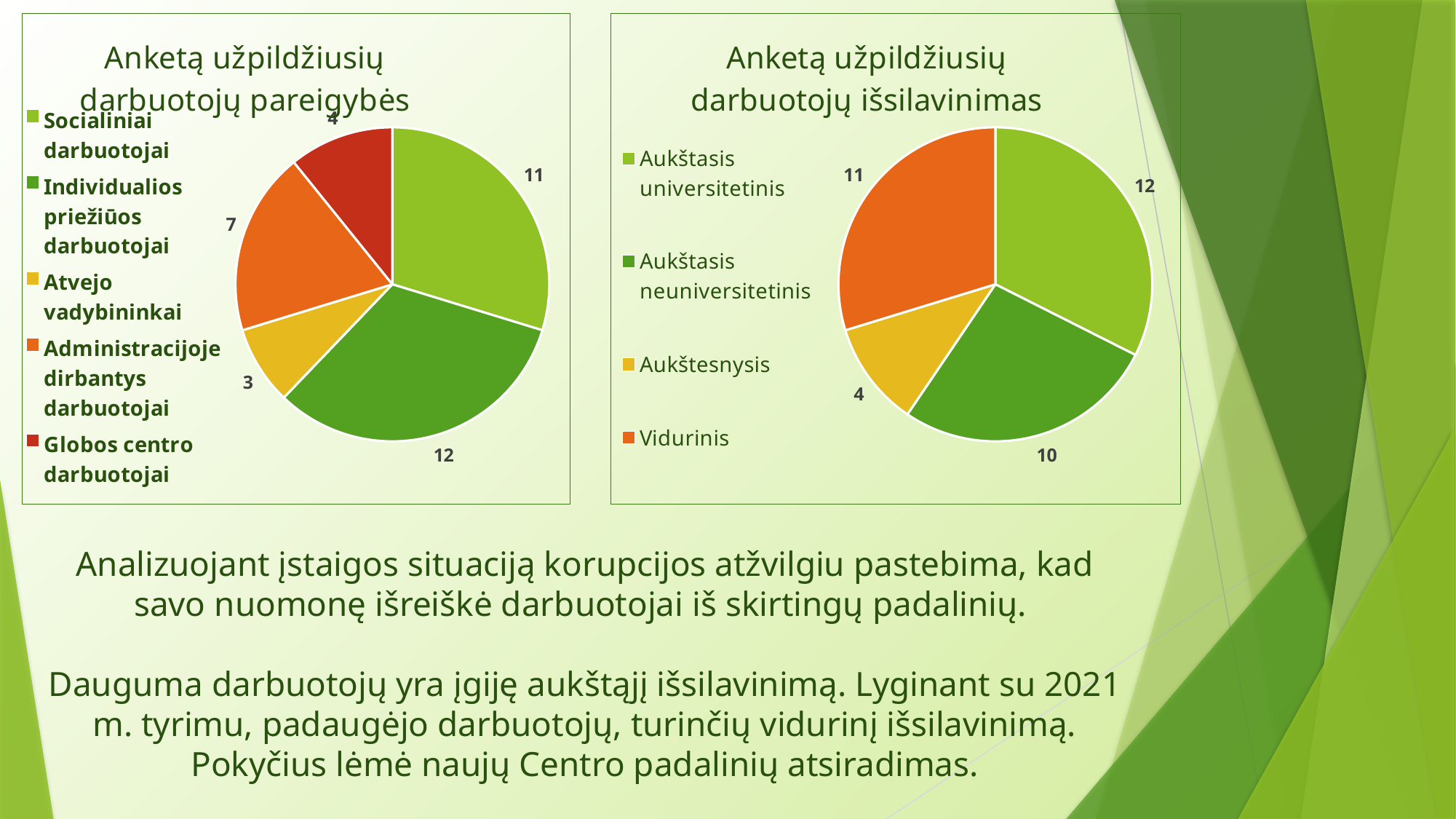
In the right chart (Anketą užpildžiusių darbuotojų išsilavinimas), which is larger: Aukštasis universitetinis or Aukštesnysis? Aukštasis universitetinis What type of chart is the right chart (Anketą užpildžiusių darbuotojų išsilavinimas)? Pie chart In the left chart (Anketą užpildžiusių darbuotojų pareigybės), which category has the smallest slice? Atvejo vadybininkai In the left chart (Anketą užpildžiusių darbuotojų pareigybės), what is the value for Atvejo vadybininkai? 3 In the left chart (Anketą užpildžiusių darbuotojų pareigybės), what is the value for Socialiniai darbuotojai? 11 In the left chart (Anketą užpildžiusių darbuotojų pareigybės), how many categories are shown? 5 In the right chart (Anketą užpildžiusių darbuotojų išsilavinimas), what is the difference between Aukštasis universitetinis and Aukštesnysis? 8 In the left chart (Anketą užpildžiusių darbuotojų pareigybės), which category has the largest slice? Individualios priežiūos darbuotojai In the right chart (Anketą užpildžiusių darbuotojų išsilavinimas), what is the value for Aukštasis neuniversitetinis? 10 In the right chart (Anketą užpildžiusių darbuotojų išsilavinimas), what is the value for Vidurinis? 11 In the right chart (Anketą užpildžiusių darbuotojų išsilavinimas), which category has the smallest slice? Aukštesnysis In the left chart (Anketą užpildžiusių darbuotojų pareigybės), what is the difference between Administracijoje dirbantys darbuotojai and Globos centro darbuotojai? 3